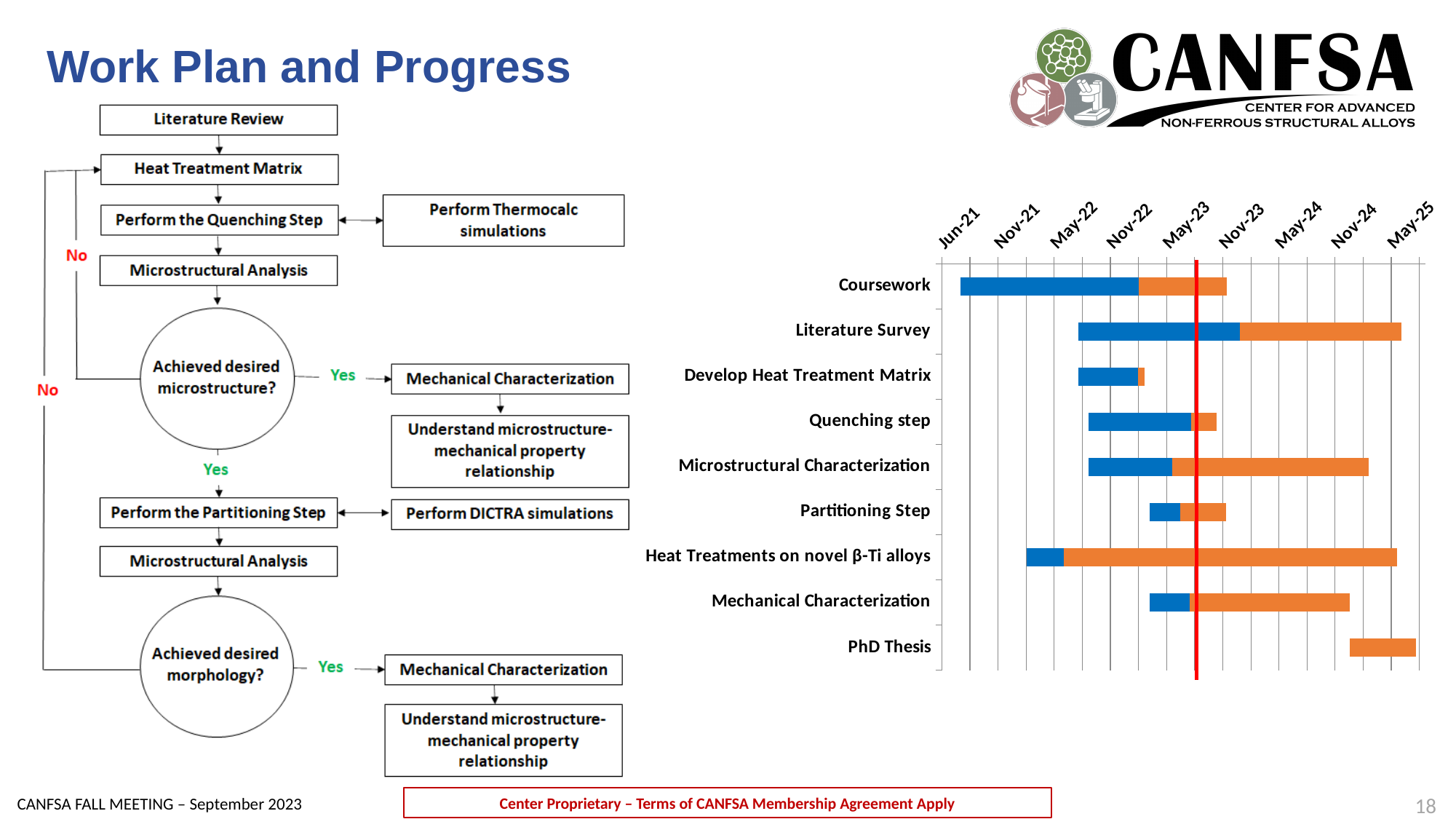
Which task in the Gantt chart starts earliest? Coursework Which task in the Gantt chart has the longest bar? Heat Treatments on novel β-Ti alloys Which task in the Gantt chart starts latest? PhD Thesis Which task in the Gantt chart has a bar that is entirely orange? PhD Thesis Which task starts earlier in the Gantt chart, Quenching step or Partitioning Step? Quenching step Does the Mechanical Characterization bar in the Gantt chart start before or after May-23? before Which task starts earlier in the Gantt chart, Coursework or Literature Survey? Coursework Does the Coursework bar in the Gantt chart start before or after Nov-21? before What kind of chart is shown on the right side of the slide? Bar chart (Gantt chart) How many tasks are listed on the vertical axis of the Gantt chart? 9 Between which two axis labels does the red vertical line in the Gantt chart fall? May-23 and Nov-23